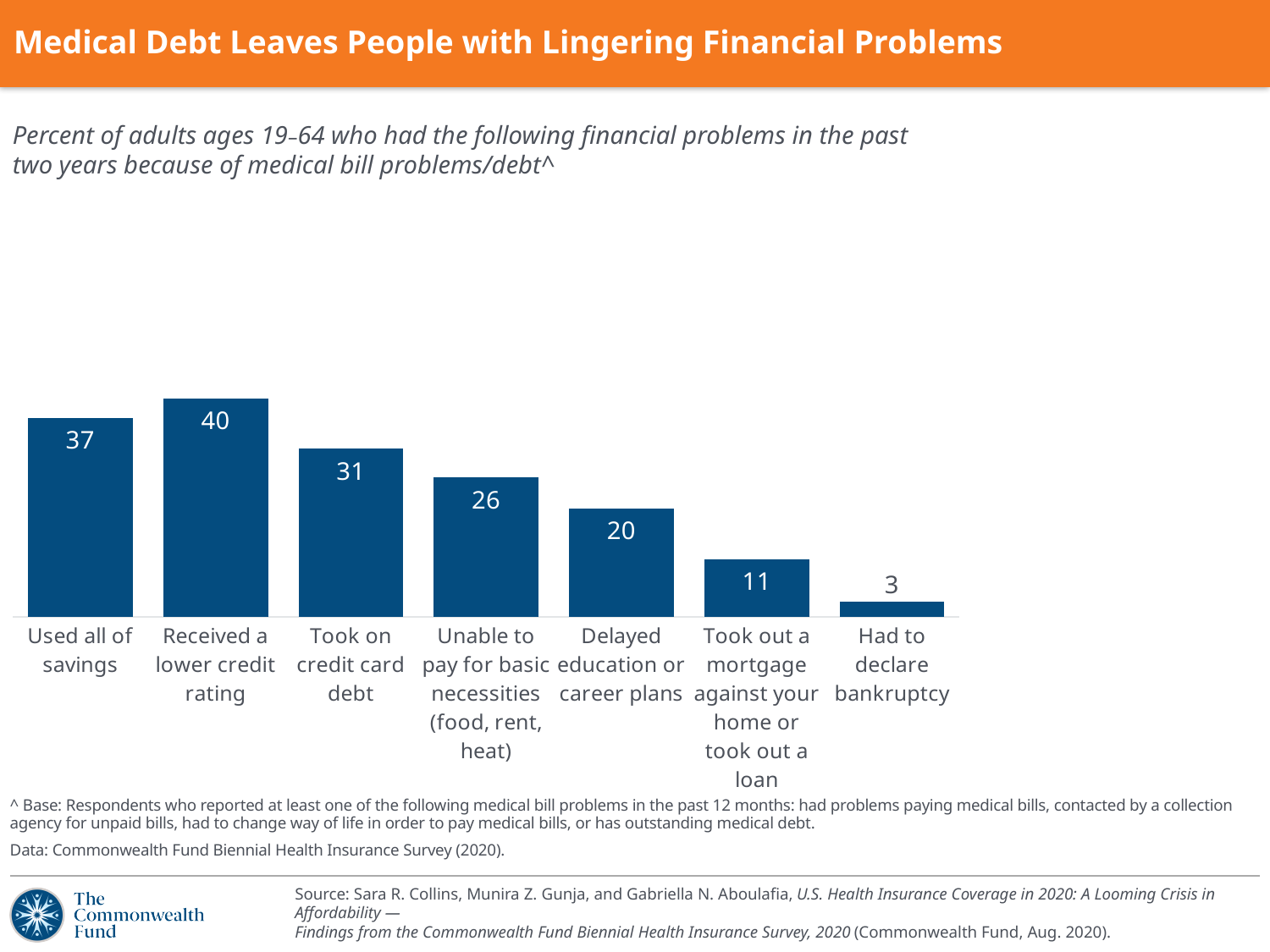
What is the value for 'Took out a mortgage against your home or took out a loan'? 11 What is the title of the slide? Medical Debt Leaves People with Lingering Financial Problems What is the difference between the values for 'Received a lower credit rating' and 'Used all of savings'? 3 What is the difference between the values for 'Unable to pay for basic necessities (food, rent, heat)' and 'Had to declare bankruptcy'? 23 What percent of adults used all of their savings because of medical bill problems/debt? 37 How many financial problem categories are shown on the chart? 7 Which financial problem has the lowest value on the chart? Had to declare bankruptcy Which is larger: the value for 'Delayed education or career plans' or the value for 'Took on credit card debt'? Took on credit card debt What kind of chart is shown on the slide? Bar chart Which financial problem has the highest value on the chart? Received a lower credit rating Do the values generally rise or fall from 'Received a lower credit rating' to 'Had to declare bankruptcy'? Fall What is the value for 'Took on credit card debt'? 31